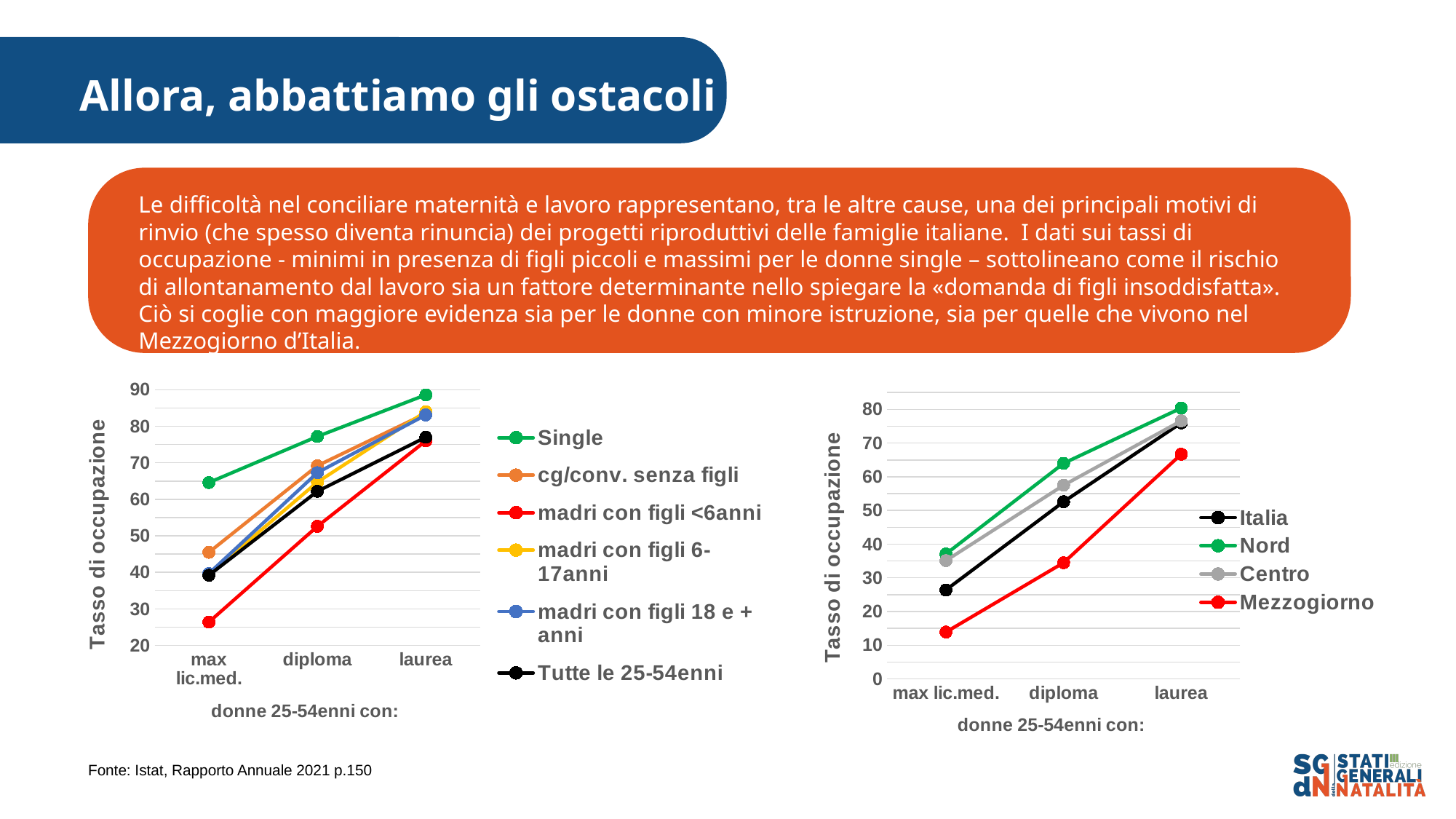
What kind of chart is the left chart on the slide? line chart In the left chart, which series has the lowest value at 'max lic.med.'? madri con figli <6anni In the right chart, do the values for 'Italia' rise or fall from 'max lic.med.' to 'laurea'? rise How many series does the legend of the right chart list? 4 In the right chart, which is larger at 'diploma': the value for 'Nord' or the value for 'Italia'? Nord In the left chart, which series has the highest value at 'laurea'? Single How many categories are shown on the x axis of the right chart? 3 In the right chart, is the value for 'Mezzogiorno' at 'max lic.med.' greater or less than 20? less In the left chart, is the value for 'Single' at 'laurea' greater or less than 80? greater How many series does the legend of the left chart list? 6 In the right chart, which series has the lowest value at 'diploma'? Mezzogiorno In the left chart, is the value for 'madri con figli <6anni' at 'max lic.med.' greater or less than 30? less